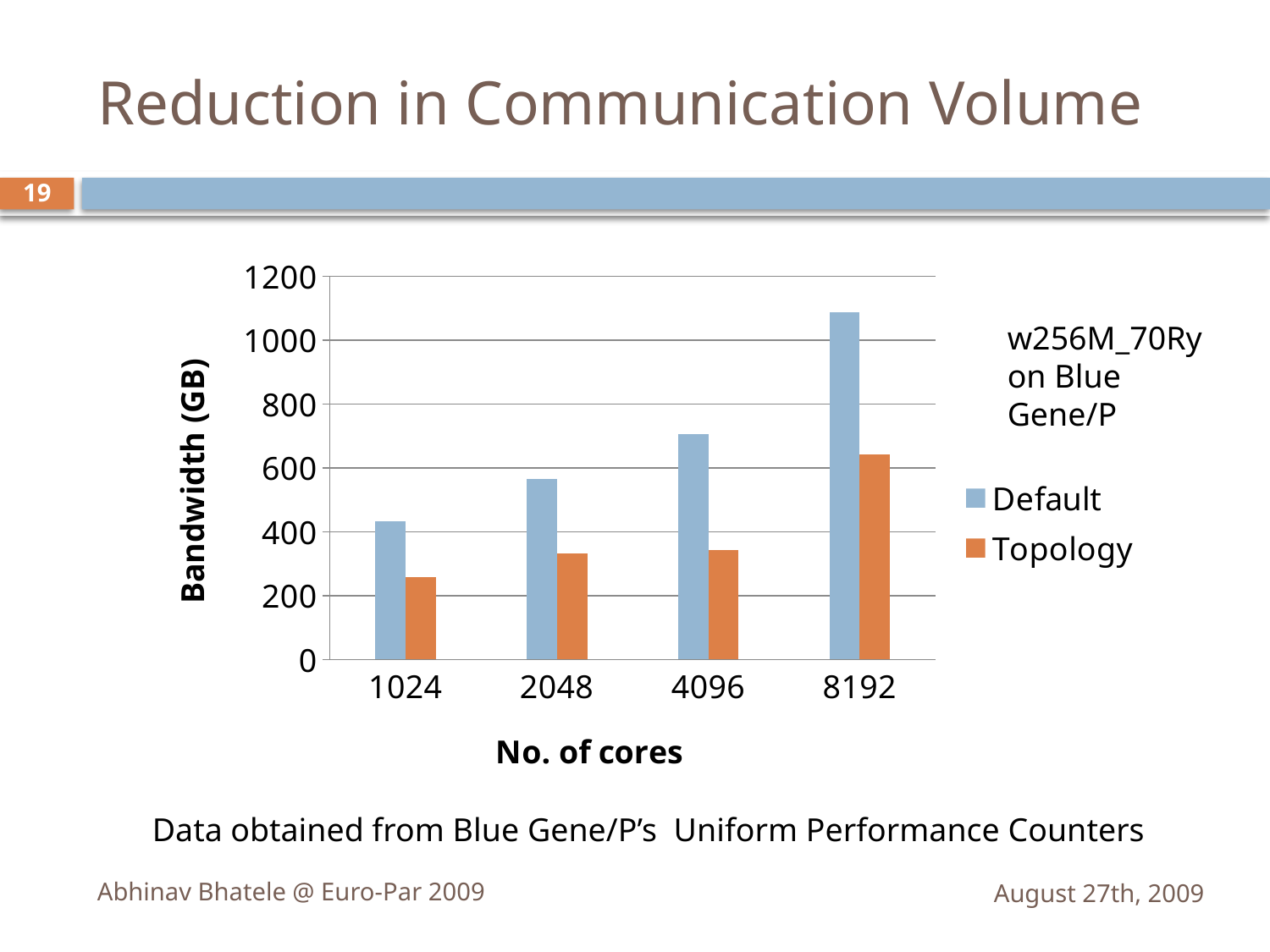
Is the Default bandwidth at 2048 cores greater or less than 400? greater Is the Default bandwidth at 8192 cores greater or less than 1000? greater How many series does the legend list? 2 At which number of cores is the Default bandwidth highest? 8192 How many core counts (categories) are shown on the x axis? 4 Is the Topology bandwidth at 1024 cores greater or less than 400? less What is the label of the y axis? Bandwidth (GB) Does the Default bandwidth rise or fall as the number of cores increases? rises At which number of cores is the Topology bandwidth lowest? 1024 At 4096 cores, which is larger: the Default or the Topology bandwidth? Default Which series is shown in orange? Topology What kind of chart is shown on the slide? bar chart